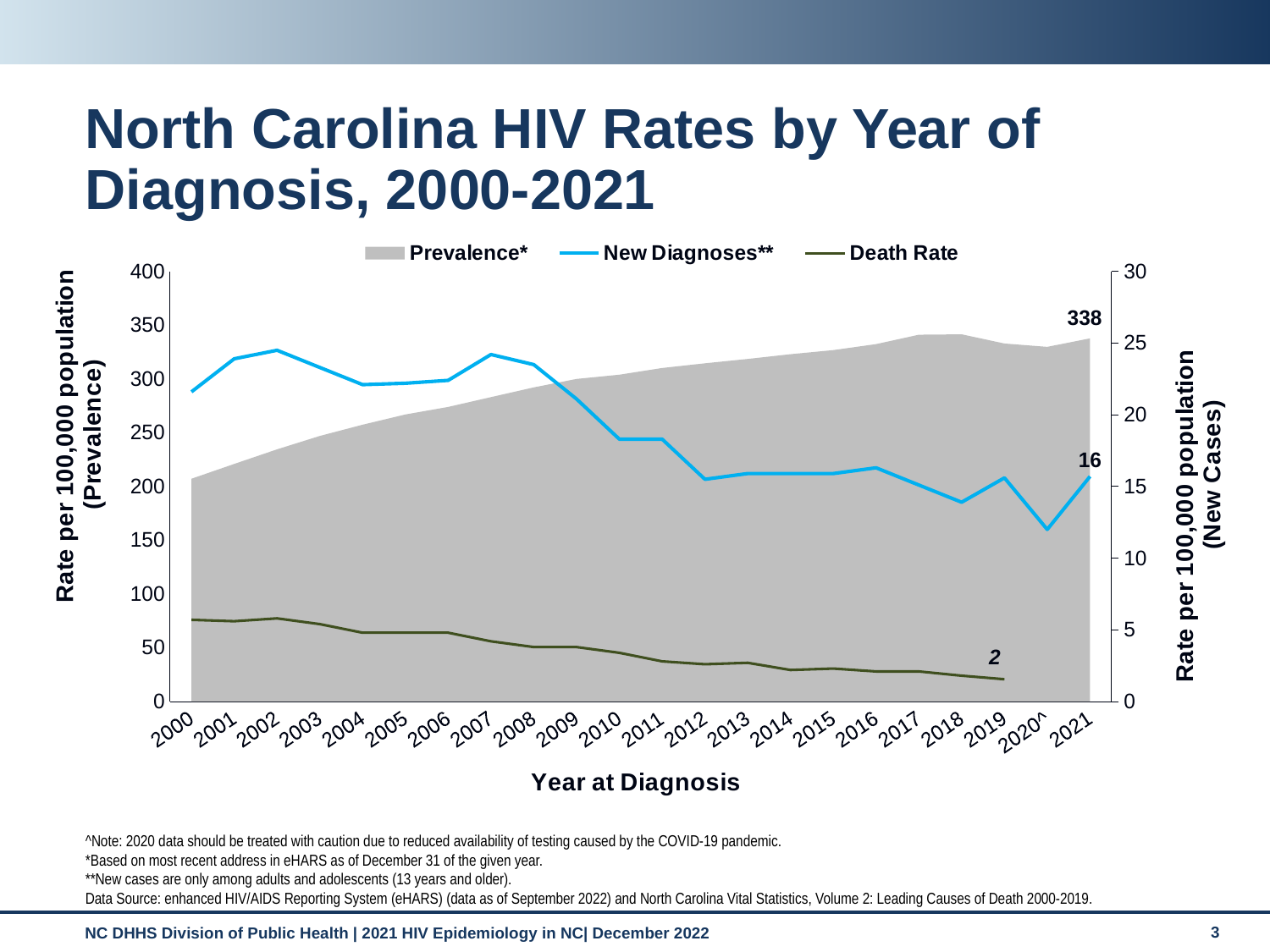
What is the title of the chart slide? North Carolina HIV Rates by Year of Diagnosis, 2000-2021 How many series does the legend list? 3 In which year is the New Diagnoses rate lowest? 2020 Does the Death Rate series generally rise or fall from 2000 to 2019? fall Which year has the higher New Diagnoses rate, 2000 or 2021? 2000 Does the Prevalence series generally rise or fall from 2000 to 2021? rise What is the labeled new diagnoses rate per 100,000 population in 2021? 16 How many years are shown along the x axis? 22 Is the New Diagnoses value for 2020 greater or less than 15? less What is the labeled prevalence rate per 100,000 population in 2021? 338 What is the labeled death rate value shown at the end of the Death Rate line in 2019? 2 Is the Prevalence value for 2000 greater or less than 250? less